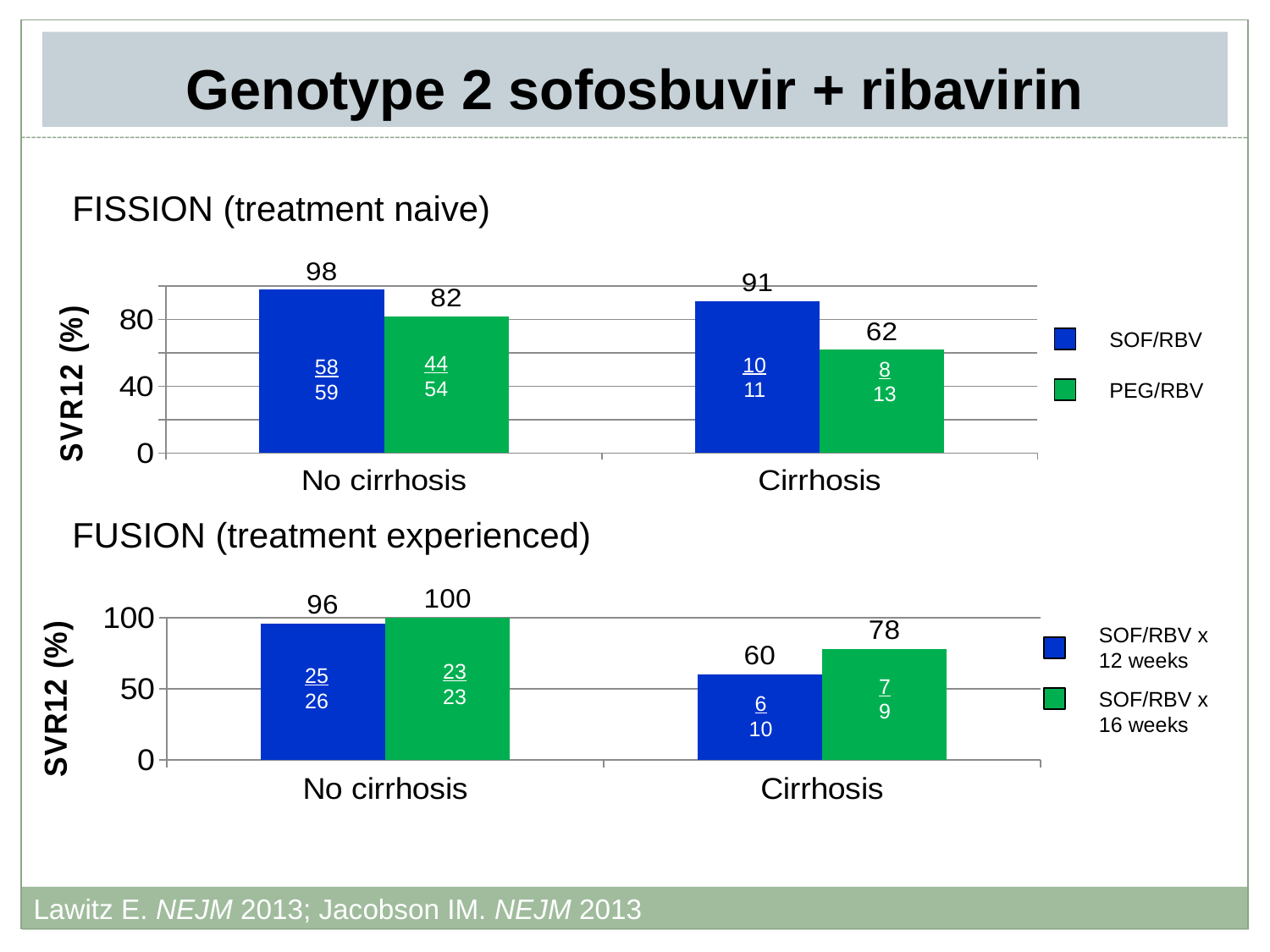
In the FISSION (treatment naive) chart, which bar has the lowest SVR12 (%)? PEG/RBV, Cirrhosis How many series does the legend of the FUSION (treatment experienced) chart list? 2 In the FUSION (treatment experienced) chart, what is the SVR12 (%) for SOF/RBV x 12 weeks in the No cirrhosis group? 96 In the FUSION (treatment experienced) chart, which bar has the highest SVR12 (%)? SOF/RBV x 16 weeks, No cirrhosis In the FUSION (treatment experienced) chart, what is the difference in SVR12 (%) between SOF/RBV x 16 weeks and SOF/RBV x 12 weeks in the Cirrhosis group? 18 In the FISSION (treatment naive) chart, what is the SVR12 (%) for SOF/RBV in the No cirrhosis group? 98 In the FISSION (treatment naive) chart, which is larger in the No cirrhosis group: SOF/RBV or PEG/RBV? SOF/RBV What kind of chart is the FISSION (treatment naive) chart? Bar chart In the FISSION (treatment naive) chart, what is the difference in SVR12 (%) between SOF/RBV and PEG/RBV in the Cirrhosis group? 29 In the FUSION (treatment experienced) chart, what is the SVR12 (%) for SOF/RBV x 16 weeks in the Cirrhosis group? 78 In the FISSION (treatment naive) chart, what colour are the PEG/RBV bars? Green In the FISSION (treatment naive) chart, what is the SVR12 (%) for PEG/RBV in the Cirrhosis group? 62